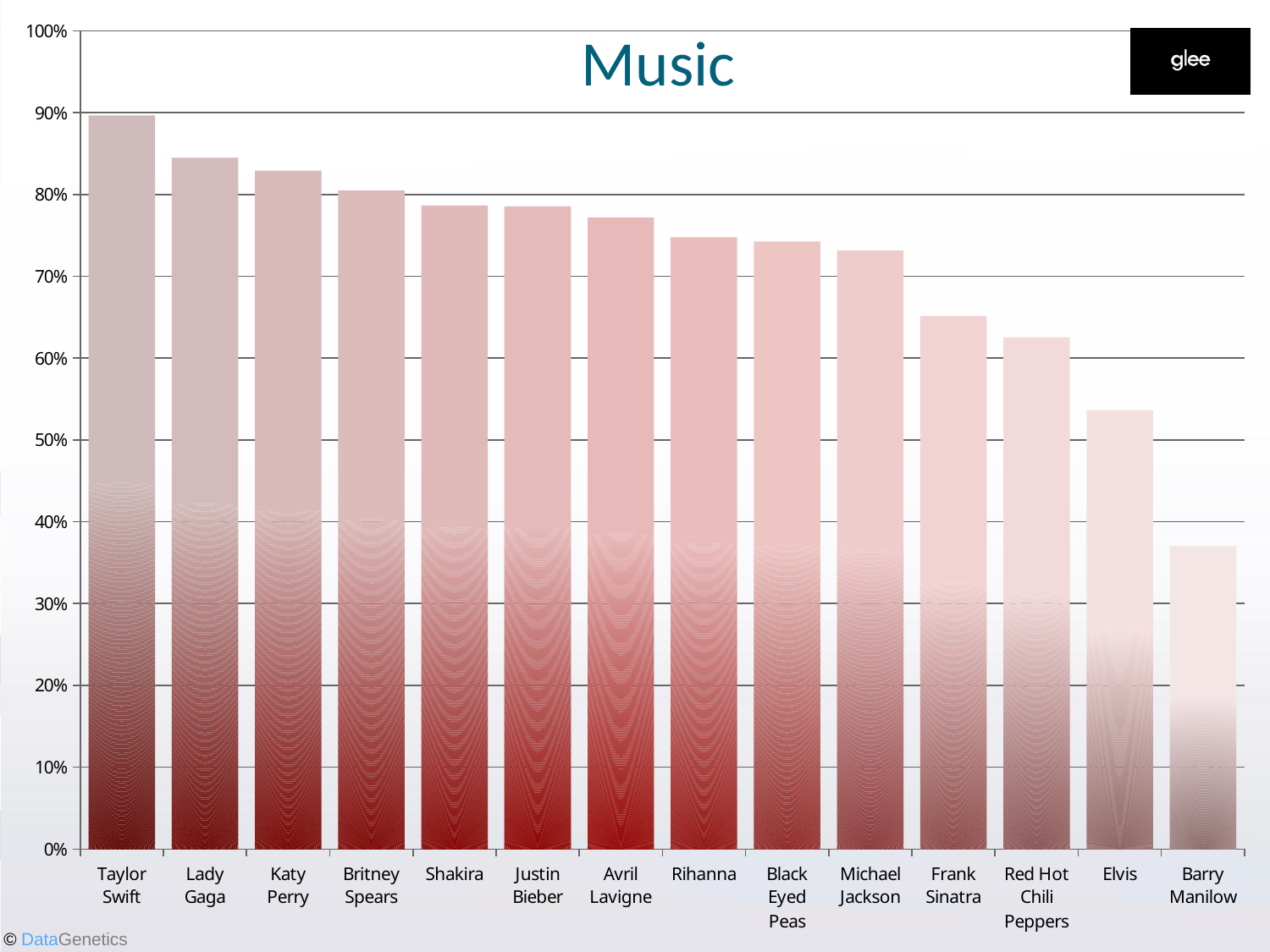
Which is larger, the value for Lady Gaga or the value for Rihanna? Lady Gaga Is the value for Taylor Swift greater or less than 80%? greater Which artist has the highest value on the chart? Taylor Swift Is the value for Frank Sinatra greater or less than 70%? less What is the title of the chart? Music Is the value for Elvis greater or less than 50%? greater Which artist has the lowest value on the chart? Barry Manilow Which is larger, the value for Red Hot Chili Peppers or the value for Elvis? Red Hot Chili Peppers How many categories (artists) are shown on the chart? 14 Do the values rise or fall moving from left to right along the x axis? fall What kind of chart is shown on the slide? bar chart